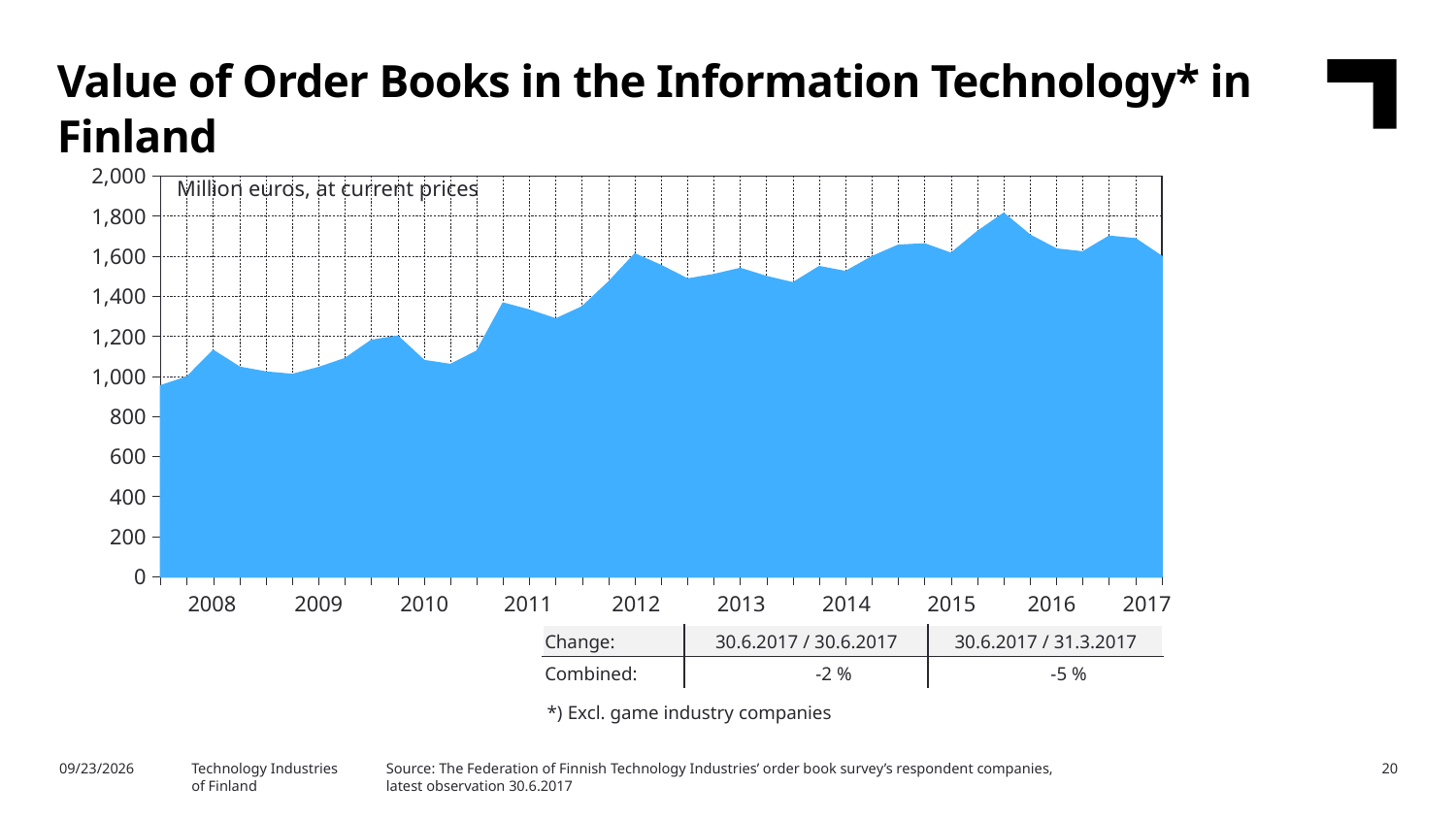
What kind of chart is shown on the slide? area chart How many year labels are shown on the x axis? 10 What is the combined change for 30.6.2017 / 31.3.2017 shown in the table below the chart? -5 % Is the value at the start of 2013 greater or less than 1,400? greater What is the combined change for 30.6.2017 / 30.6.2017 shown in the table below the chart? -2 % Is the peak value of the order books, reached between 2015 and 2016, greater or less than 1,600? greater What is the title of the chart? Value of Order Books in the Information Technology* in Finland In what unit are the values on the chart expressed, according to the label inside the plot area? Million euros, at current prices What is the highest value shown on the y axis? 2,000 Is the value at the start of 2008 greater or less than 1,200? less Overall, do the values rise or fall from 2008 to 2017? rise